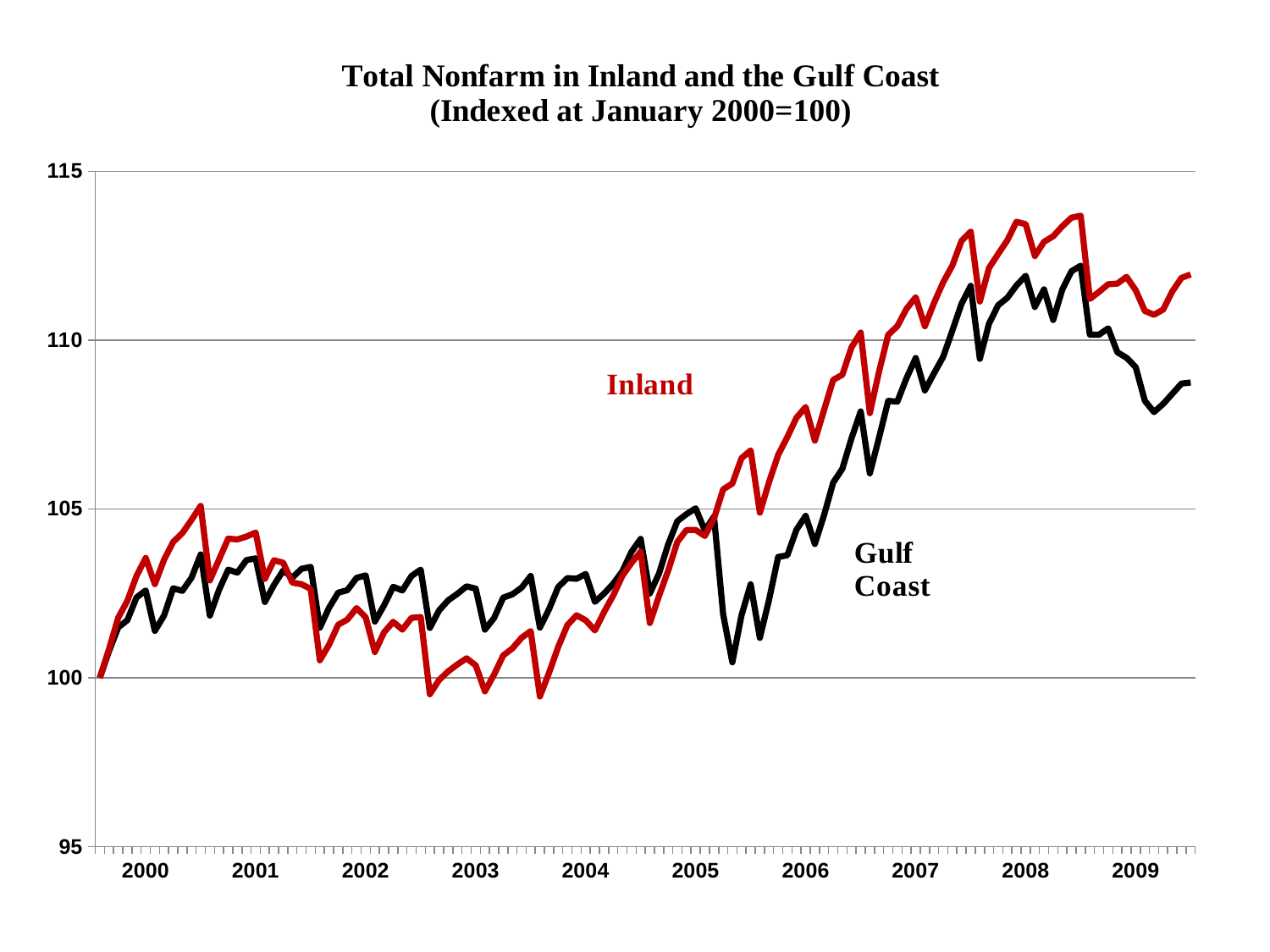
Is the Gulf Coast value at the end of 2009 greater or less than 110? less During 2003, which series is higher, Inland or Gulf Coast? Gulf Coast What colour is the Inland line? red How many year labels are shown on the x axis? 10 Is the Gulf Coast value during 2003 greater or less than 100? greater Does the Inland line rise or fall between 2005 and 2008? rise Is the Inland value at the end of 2009 greater or less than 110? greater What kind of chart is shown on the slide? line chart At the end of 2009, which series is higher, Inland or Gulf Coast? Inland What is the title of the chart? Total Nonfarm in Inland and the Gulf Coast (Indexed at January 2000=100) How many series are plotted on the chart? 2